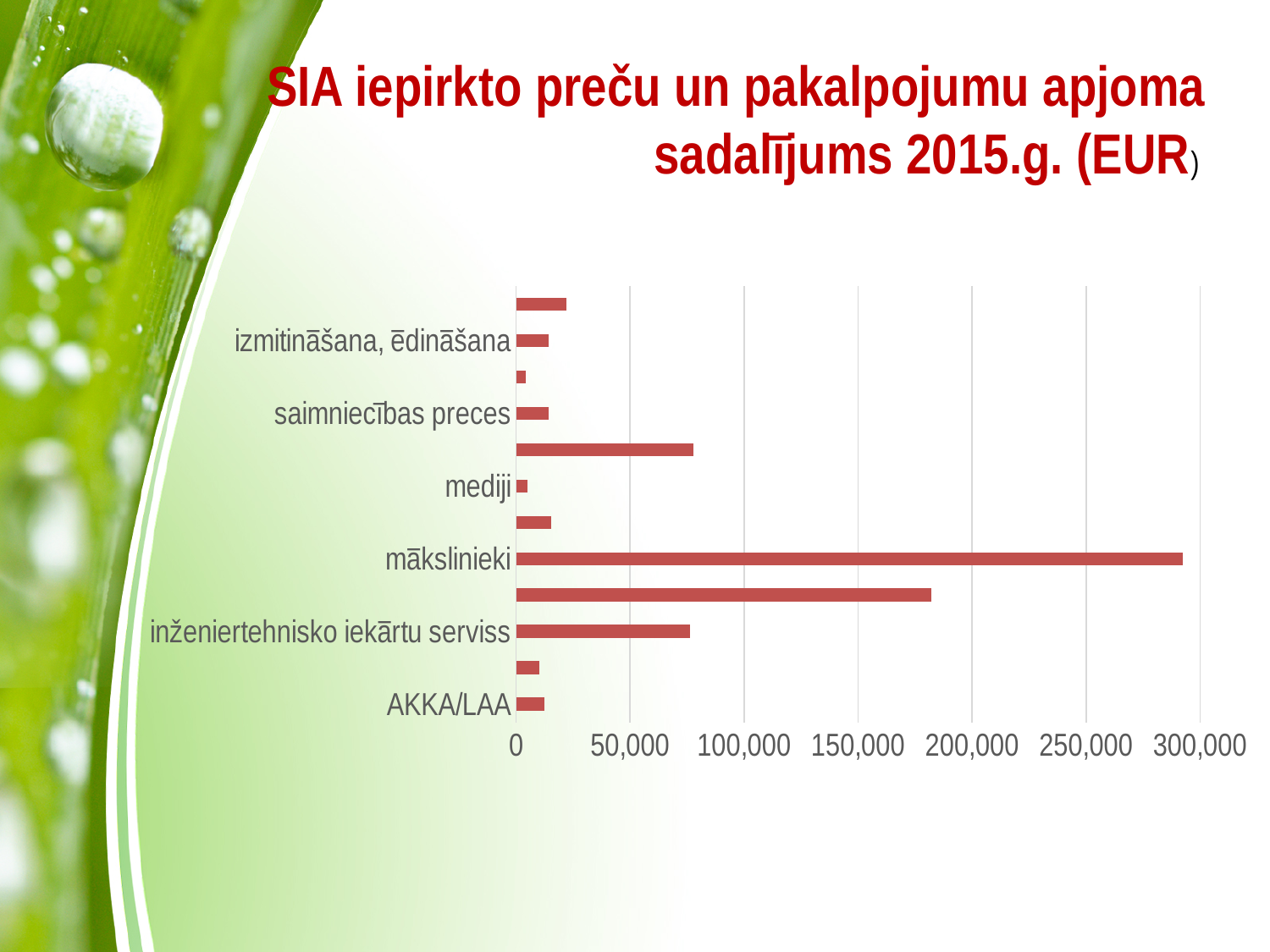
How many bars are plotted in the chart? 12 Is the value for inženiertehnisko iekārtu serviss greater or less than 50,000? greater Which labelled category has the shortest bar? mediji What is the highest value shown on the horizontal axis? 300,000 What is the title of the chart on the slide? SIA iepirkto preču un pakalpojumu apjoma sadalījums 2015.g. (EUR) What kind of chart is shown on the slide? bar chart Is the value for saimniecības preces greater or less than 50,000? less Is the value for inženiertehnisko iekārtu serviss greater or less than 100,000? less Which labelled category has the longest bar? mākslinieki Which is larger, the value for saimniecības preces or the value for mediji? saimniecības preces Which is larger, the value for mākslinieki or the value for inženiertehnisko iekārtu serviss? mākslinieki